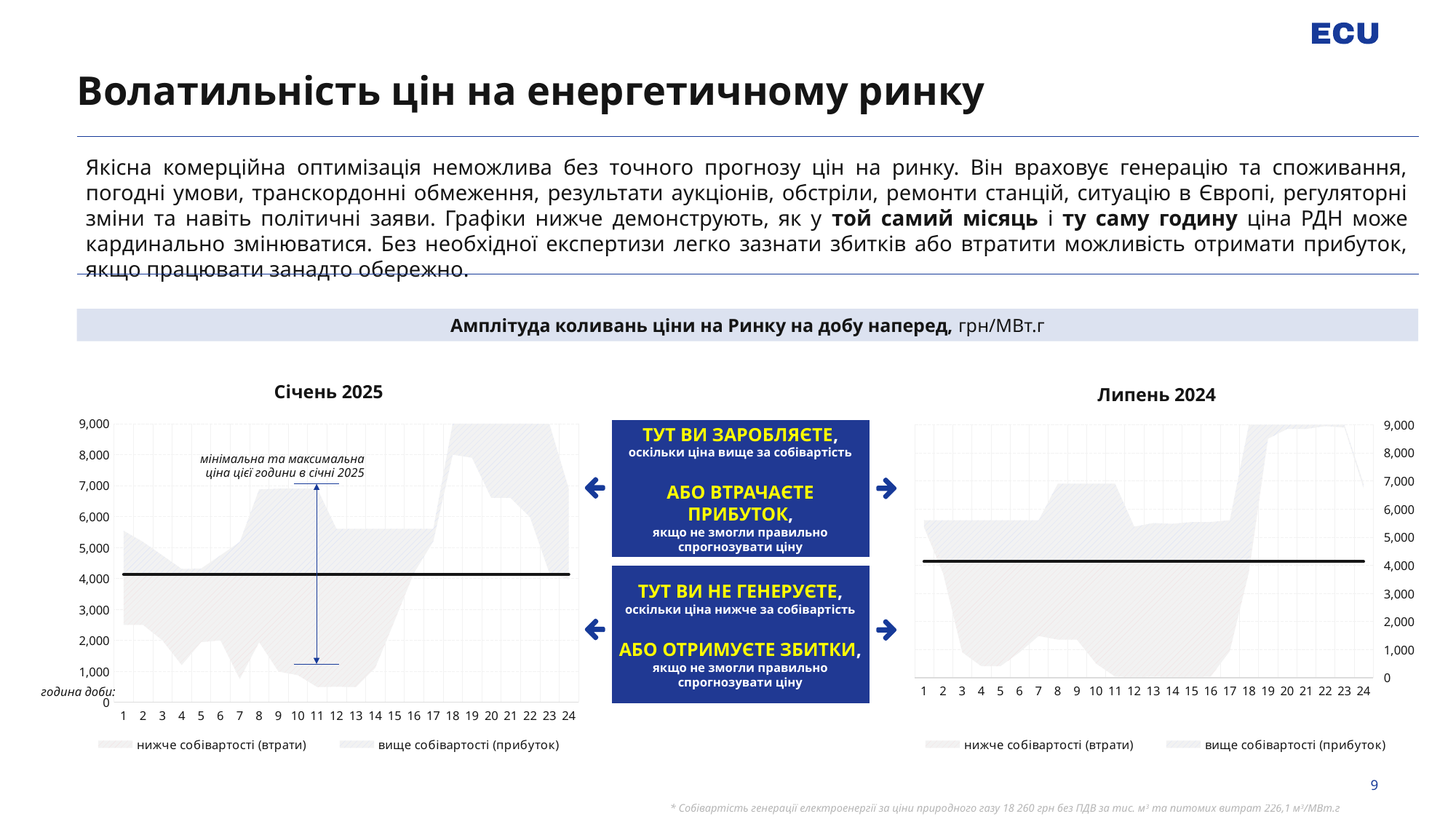
In the "Липень 2024" chart, is the minimum price at hour 14 greater or less than 1,000? less In the "Січень 2025" chart, is the minimum price at hour 12 greater or less than 2,000? less In the "Липень 2024" chart, is the horizontal cost line greater or less than 5,000? less What are the two legend entries of the "Липень 2024" chart? нижче собівартості (втрати); вище собівартості (прибуток) What unit is given in the shared heading above the two charts? грн/МВт.г What is the highest value shown on the y axis of the "Липень 2024" chart? 9,000 How many hours of the day are shown on the x axis of the "Липень 2024" chart? 24 How many series does the legend of the "Січень 2025" chart list? 2 What kind of chart is the "Січень 2025" chart? area chart